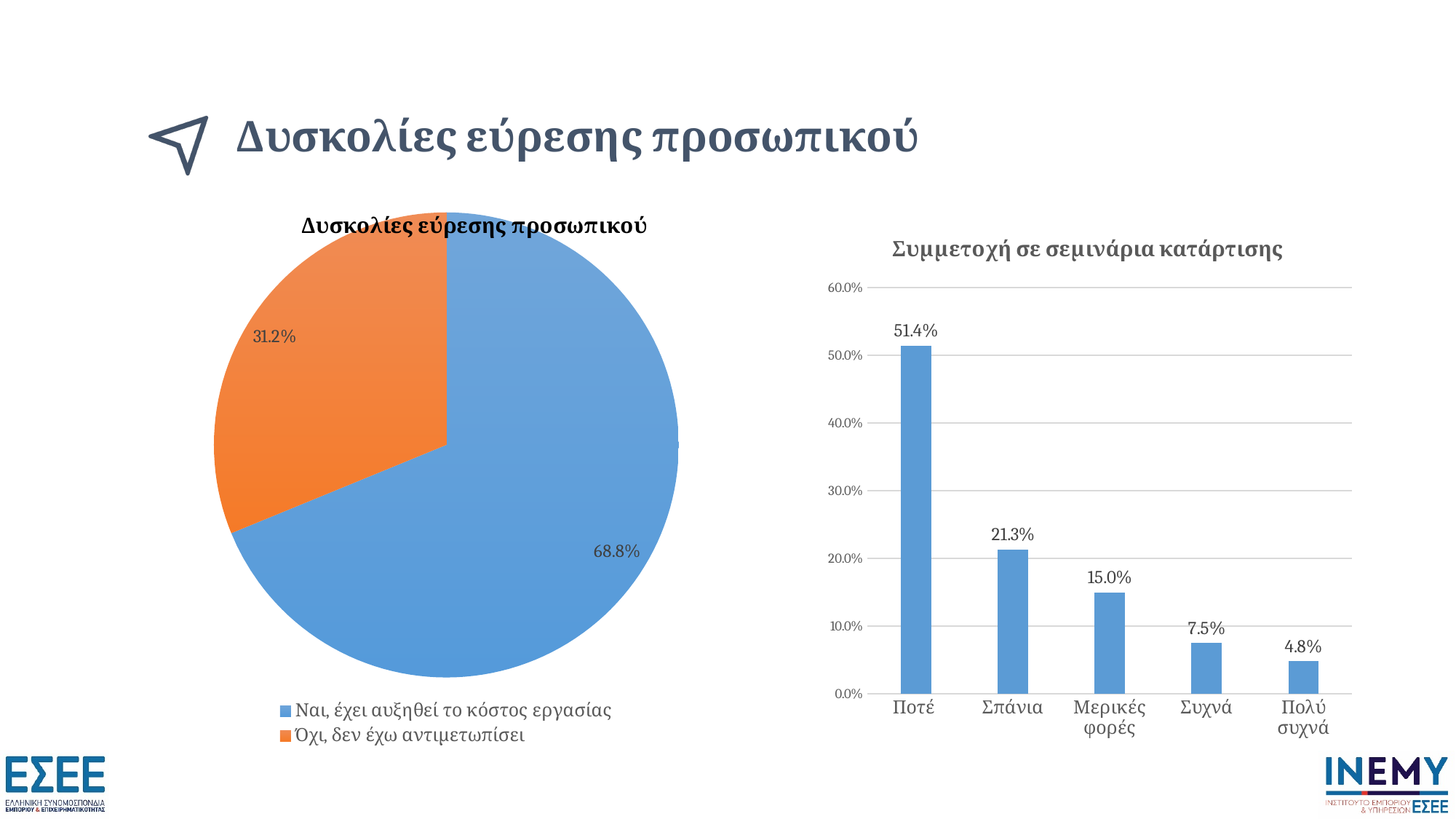
In the pie chart 'Δυσκολίες εύρεσης προσωπικού', which slice is larger? Ναι, έχει αυξηθεί το κόστος εργασίας In the chart 'Συμμετοχή σε σεμινάρια κατάρτισης', what is the difference between 'Σπάνια' and 'Συχνά'? 13.8% In the chart 'Συμμετοχή σε σεμινάρια κατάρτισης', do the values rise or fall from left to right along the x axis? Fall In the chart 'Συμμετοχή σε σεμινάρια κατάρτισης', which category has the highest value? Ποτέ In the pie chart 'Δυσκολίες εύρεσης προσωπικού', what is the difference between the two slices? 37.6% What kind of chart is the chart on the left of the slide? Pie chart How many categories are shown in the chart 'Συμμετοχή σε σεμινάρια κατάρτισης'? 5 In the chart 'Συμμετοχή σε σεμινάρια κατάρτισης', which category has the lowest value? Πολύ συχνά In the chart 'Συμμετοχή σε σεμινάρια κατάρτισης', what is the value for 'Ποτέ'? 51.4% In the pie chart 'Δυσκολίες εύρεσης προσωπικού', what share is shown for 'Ναι, έχει αυξηθεί το κόστος εργασίας'? 68.8% In the chart 'Συμμετοχή σε σεμινάρια κατάρτισης', what is the value for 'Μερικές φορές'? 15.0% In the pie chart 'Δυσκολίες εύρεσης προσωπικού', what share is shown for 'Όχι, δεν έχω αντιμετωπίσει'? 31.2%